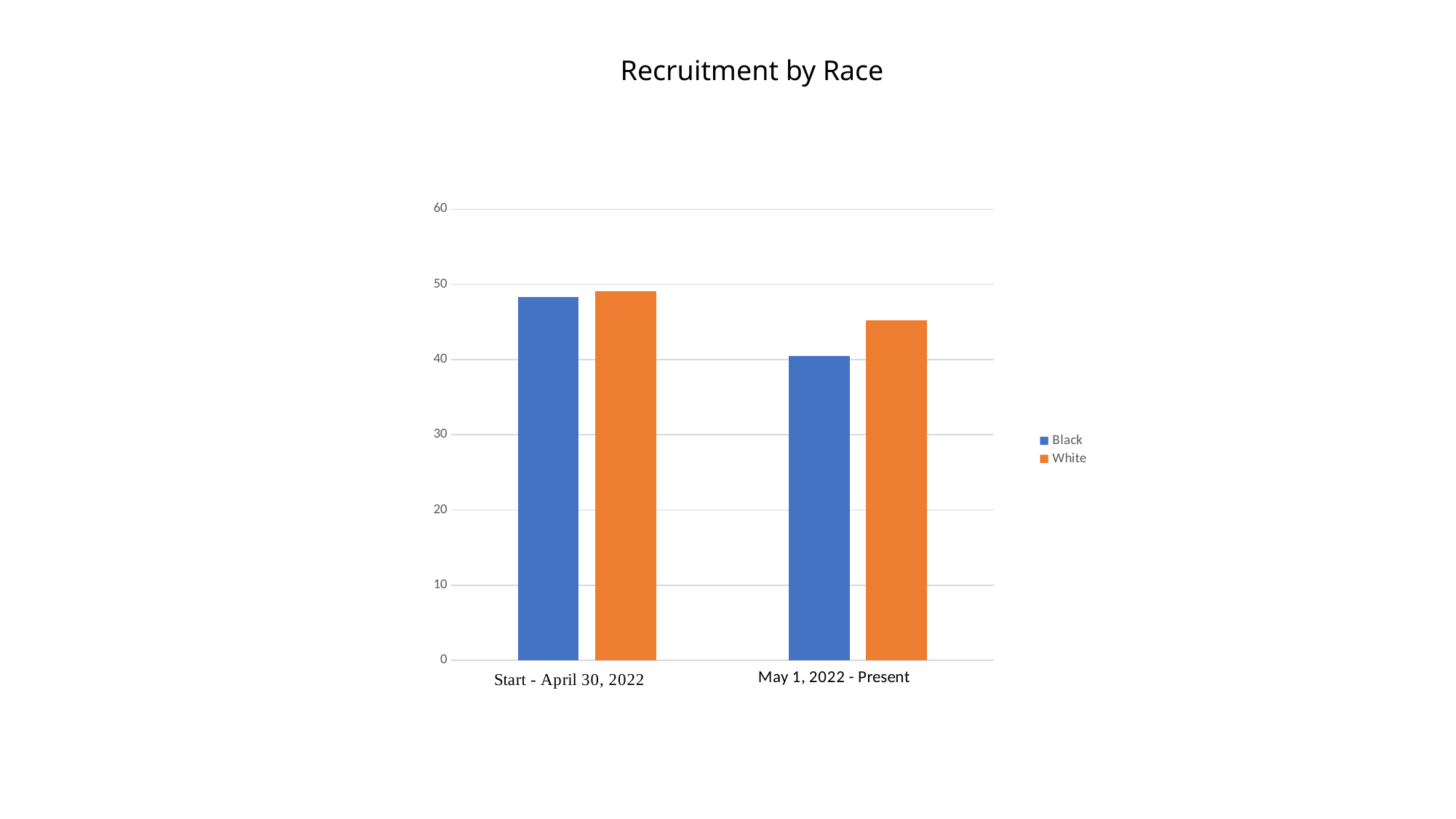
Is the value for Black in May 1, 2022 - Present greater or less than 50? less What is the title of the chart? Recruitment by Race What kind of chart is shown on the slide? bar chart Which series is shown in orange? White How many categories are shown on the x axis? 2 Is the value for White in May 1, 2022 - Present greater or less than 40? greater In May 1, 2022 - Present, which is larger, Black or White? White Is the value for Black in Start - April 30, 2022 greater or less than 50? less How many series does the legend list? 2 Does the value for White rise or fall from Start - April 30, 2022 to May 1, 2022 - Present? fall For the Black series, which category has the higher value, Start - April 30, 2022 or May 1, 2022 - Present? Start - April 30, 2022